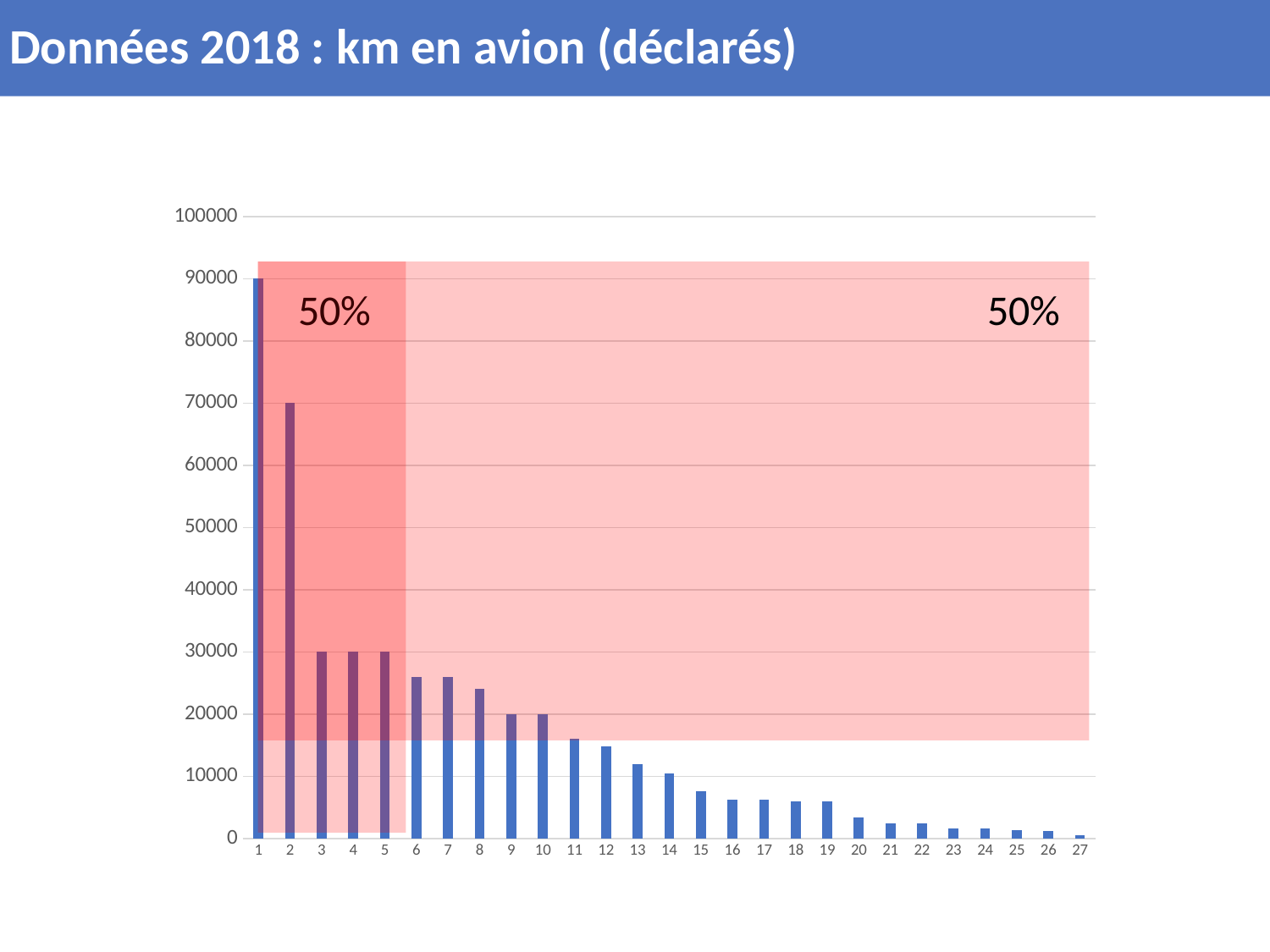
What is the value for category 1? 90000 Is the value for category 20 greater or less than 10000? less Which category has the lowest value? 27 Do the values rise or fall as you move from category 1 to category 27? fall Which has the larger value, category 3 or category 8? 3 Is the value for category 13 greater or less than 10000? greater What kind of chart is shown on the slide? bar chart Is the value for category 6 greater or less than 30000? less Which category has the highest value? 1 How many bars (categories) are plotted on the chart? 27 What is the title of the slide containing the chart? Données 2018 : km en avion (déclarés) What is the value for category 2? 70000